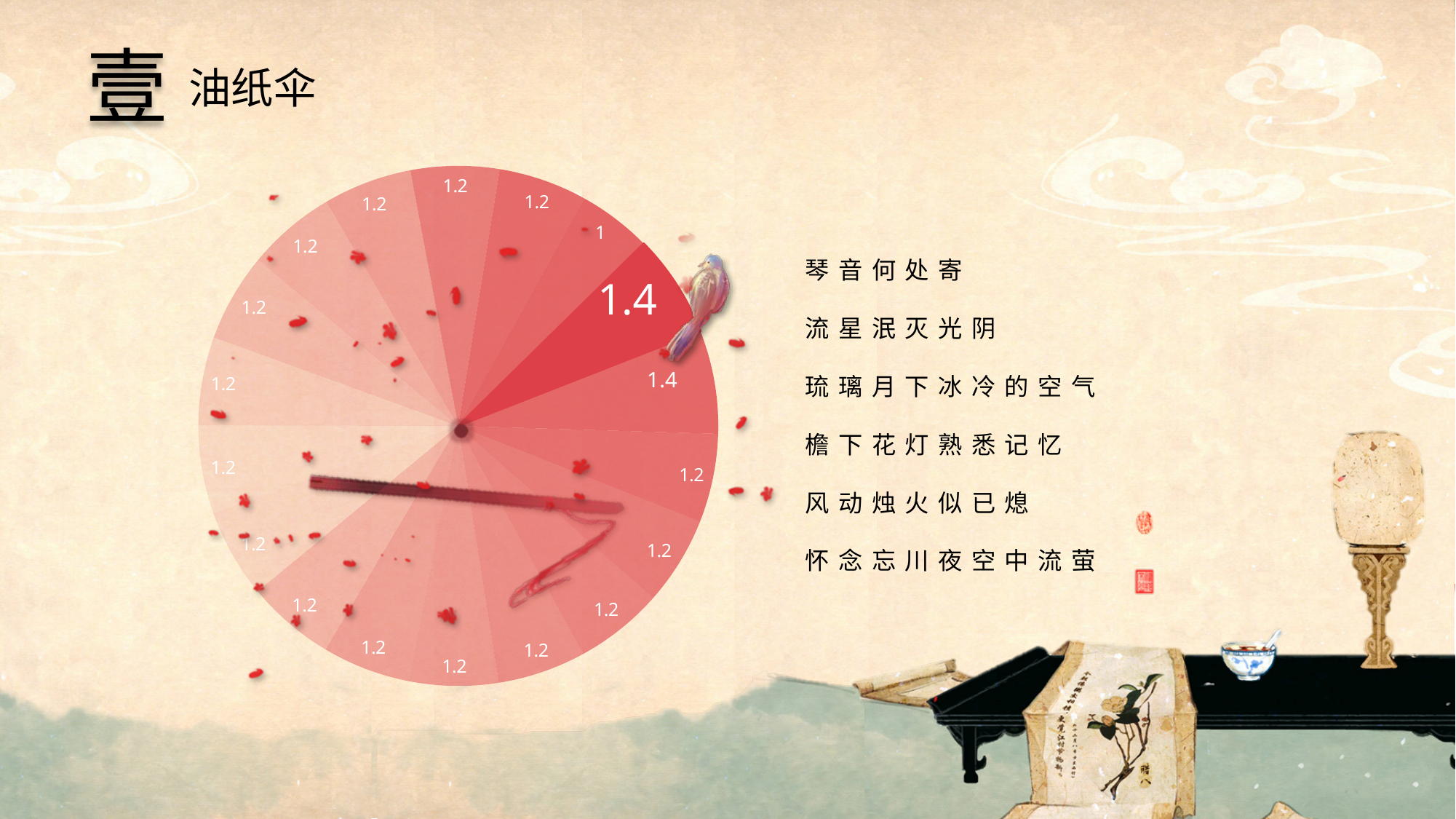
What value is printed on most of the slices of the pie chart? 1.2 Which is larger: the highlighted slice labelled 1.4 or a slice labelled 1.2? the slice labelled 1.4 Is the value of the highlighted slice greater or less than 1? greater What is the title text shown at the top of the slide next to the chart? 油纸伞 What kind of chart is shown on the slide? pie chart What is the difference between the highlighted slice's value (1.4) and a slice labelled 1.2? 0.2 What is the largest value printed on any slice of the pie chart? 1.4 What value is printed on the highlighted (exploded) slice of the pie chart? 1.4 What colour family are the slices of the pie chart drawn in? red/pink